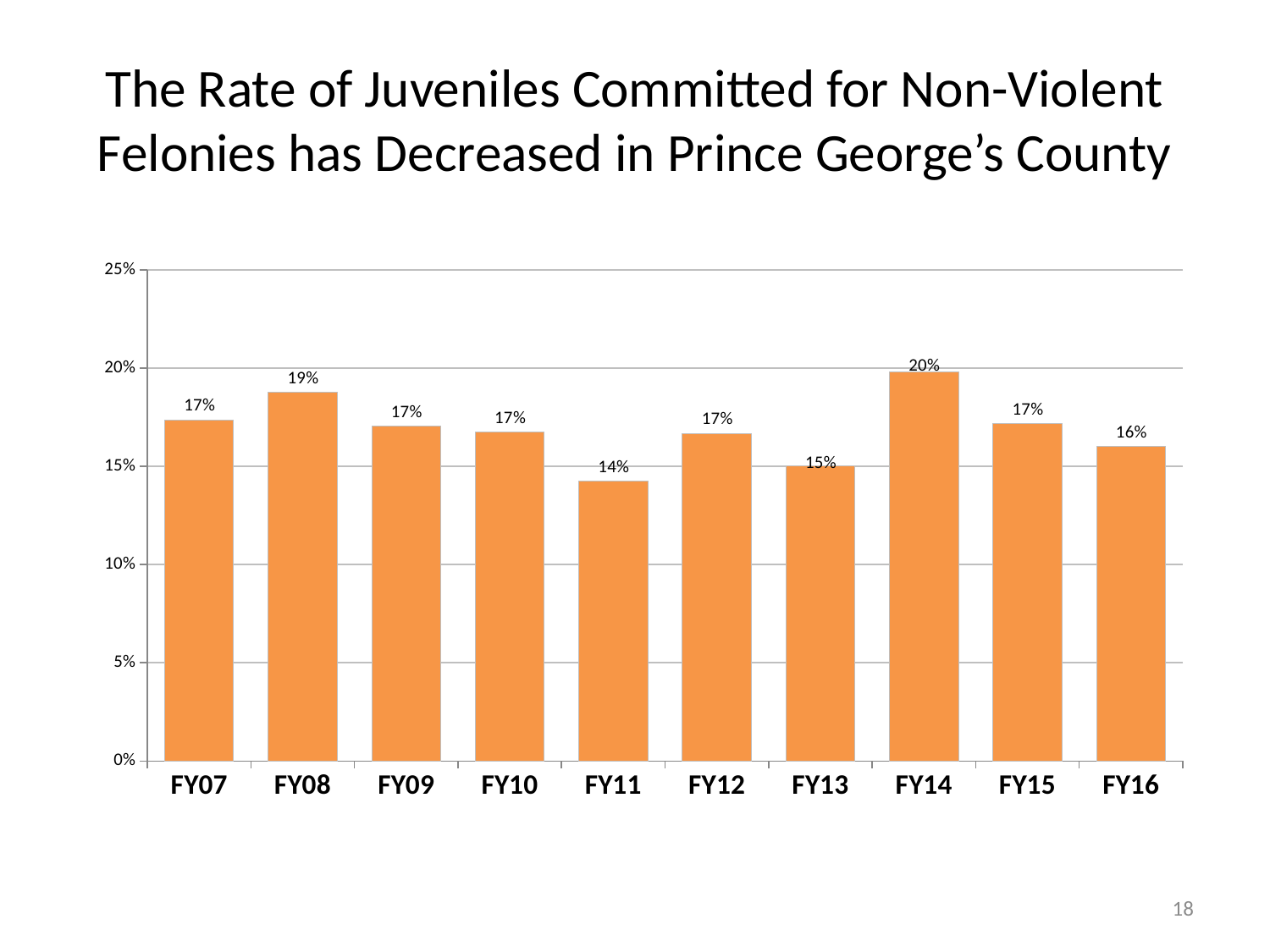
What is the value for FY08? 19% How many fiscal years are shown on the x axis? 10 Which fiscal year has the highest value? FY14 Which fiscal year has the lowest value? FY11 What is the value for FY16? 16% What colour are the bars in the chart? orange What kind of chart is shown on the slide? bar chart What is the difference between the values for FY14 and FY11? 6% Which is larger, the value for FY08 or the value for FY13? FY08 What is the value for FY14? 20% Is the value for FY11 greater or less than 15%? less What is the value for FY11? 14%